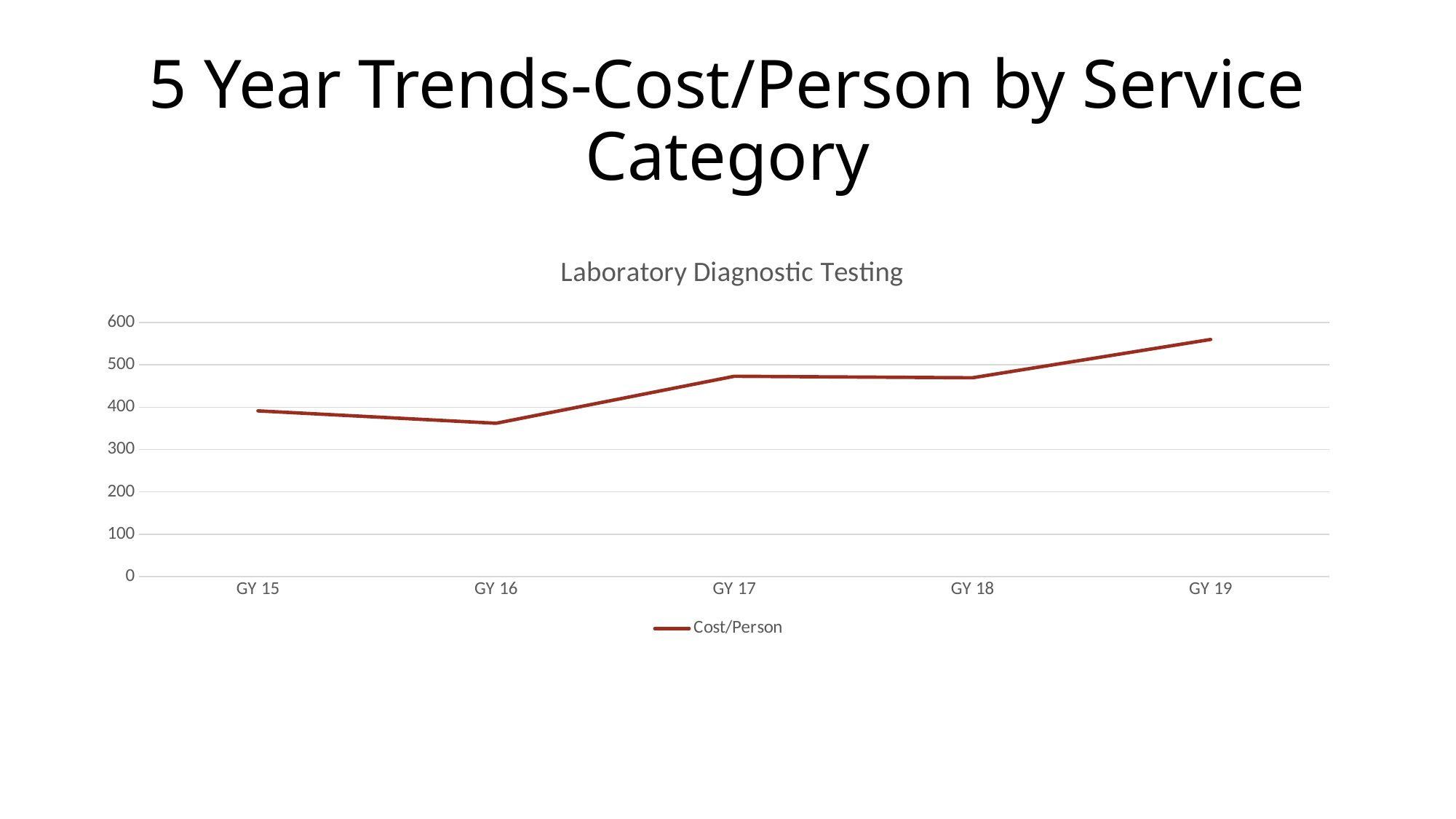
Is the Cost/Person for GY 17 greater or less than 500? less Which year has the lowest Cost/Person? GY 16 Which year has the highest Cost/Person? GY 19 Overall, does the Cost/Person rise or fall from GY 15 to GY 19? rise Is the Cost/Person for GY 16 greater or less than 400? less What type of chart is shown on the slide? Line chart How many series does the legend list? 1 What is the title of the chart? Laboratory Diagnostic Testing Is the Cost/Person for GY 19 greater or less than 500? greater Which is larger, the Cost/Person for GY 15 or for GY 16? GY 15 How many years are plotted on the x axis? 5 What is the name of the series shown in the legend? Cost/Person